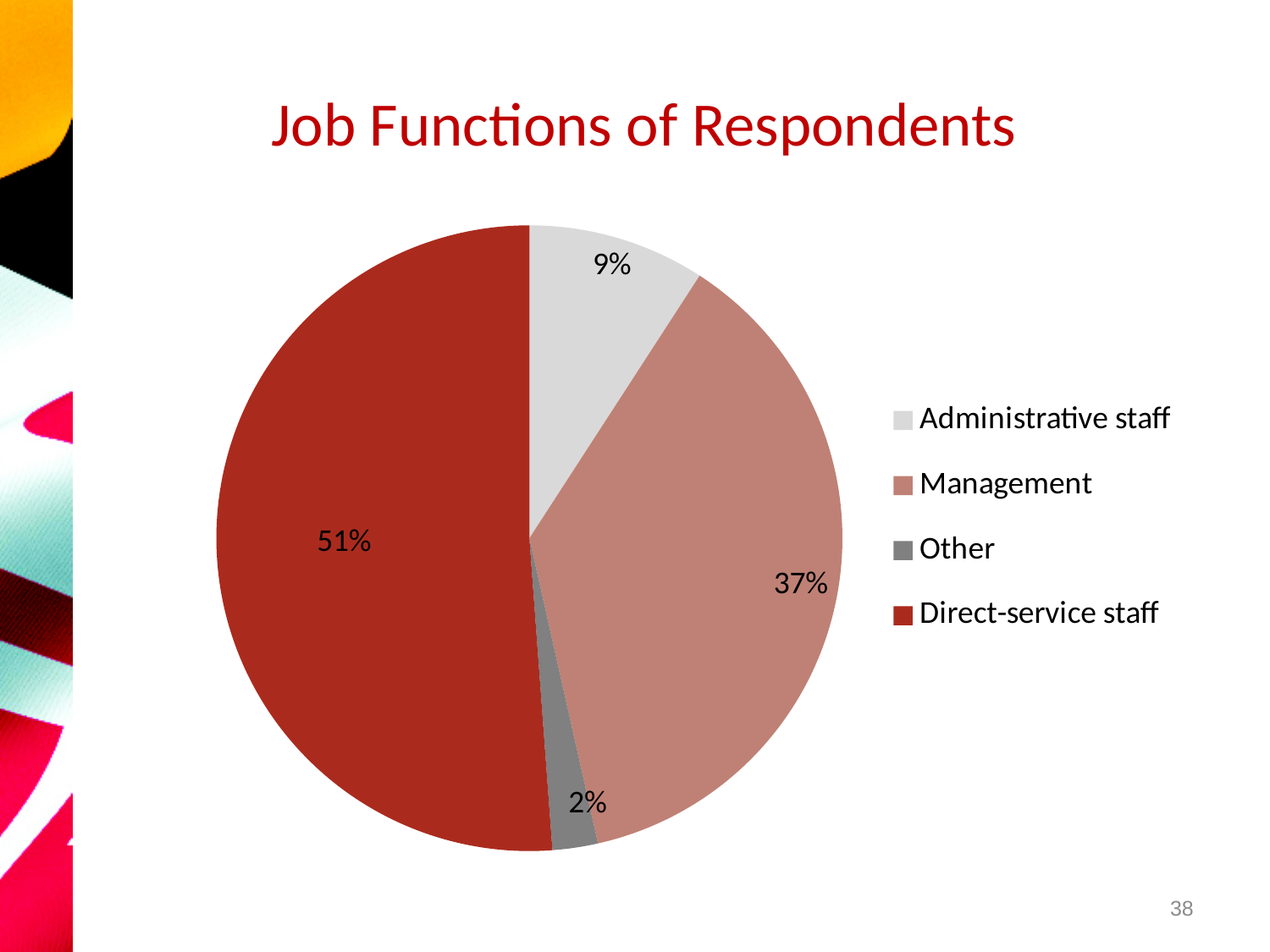
How many categories does the pie chart show? 4 What is the title of the chart? Job Functions of Respondents Which job function has the largest share of respondents? Direct-service staff What is the difference in percentage points between Administrative staff and Other? 7 What share of respondents fall under Other? 2% What is the difference in percentage points between Direct-service staff and Management? 14 What share of respondents are Administrative staff? 9% Which is larger, the share for Management or the share for Administrative staff? Management What kind of chart is shown on the slide? pie chart What share of respondents are Direct-service staff? 51% Which job function has the smallest share of respondents? Other